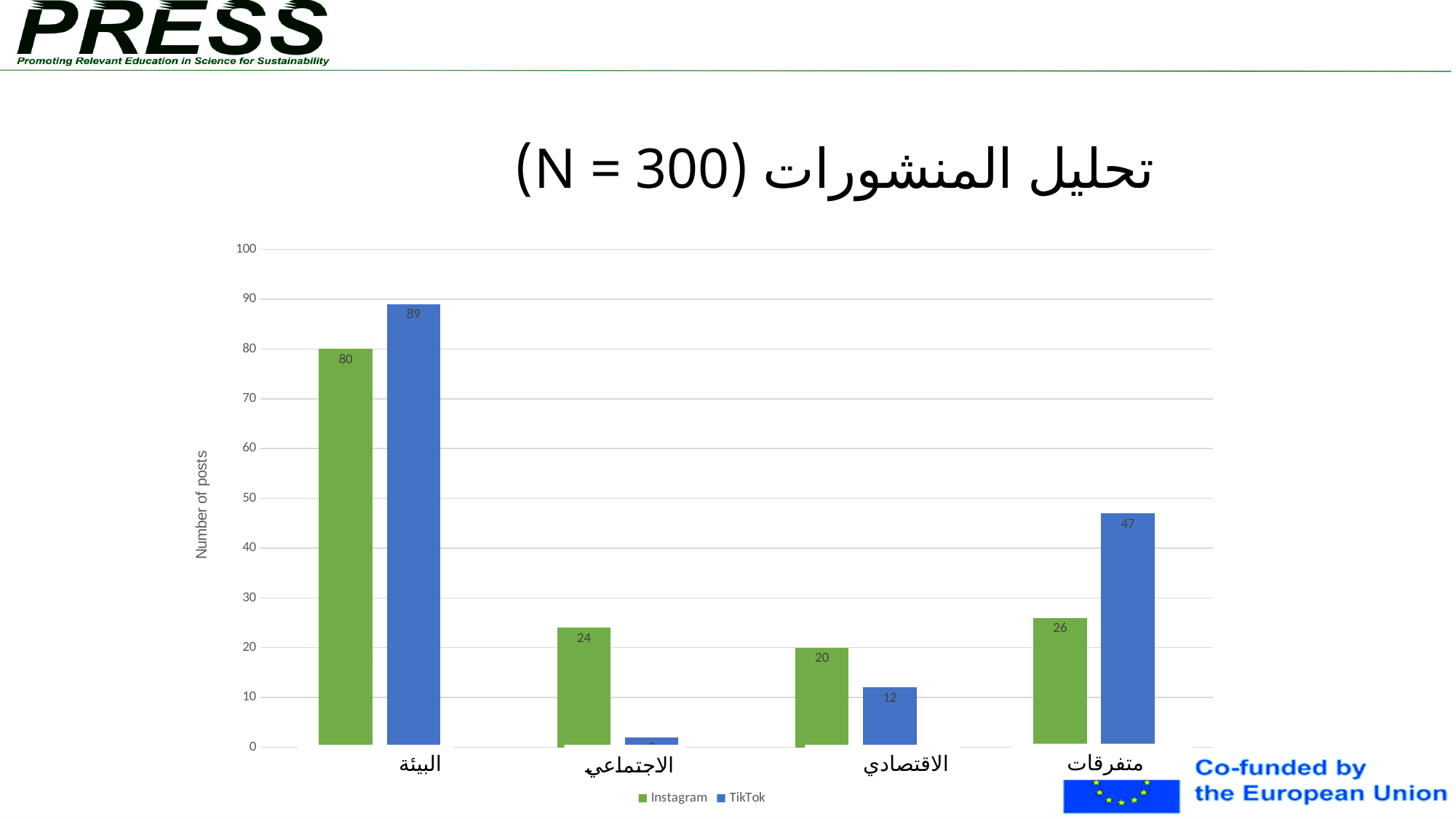
How many categories are shown on the x axis? 4 Which category has the highest TikTok value? البيئة What is the difference between the TikTok and Instagram values for البيئة? 9 What is the TikTok value for متفرقات? 47 Which category has the lowest Instagram value? الاقتصادي What is the TikTok value for البيئة? 89 What kind of chart is shown on the slide? bar chart How many series does the legend list? 2 Which is larger for متفرقات, the Instagram value or the TikTok value? TikTok What is the Instagram value for البيئة? 80 What is the Instagram value for الاقتصادي? 20 Is the TikTok value for الاجتماعي greater or less than 10? less